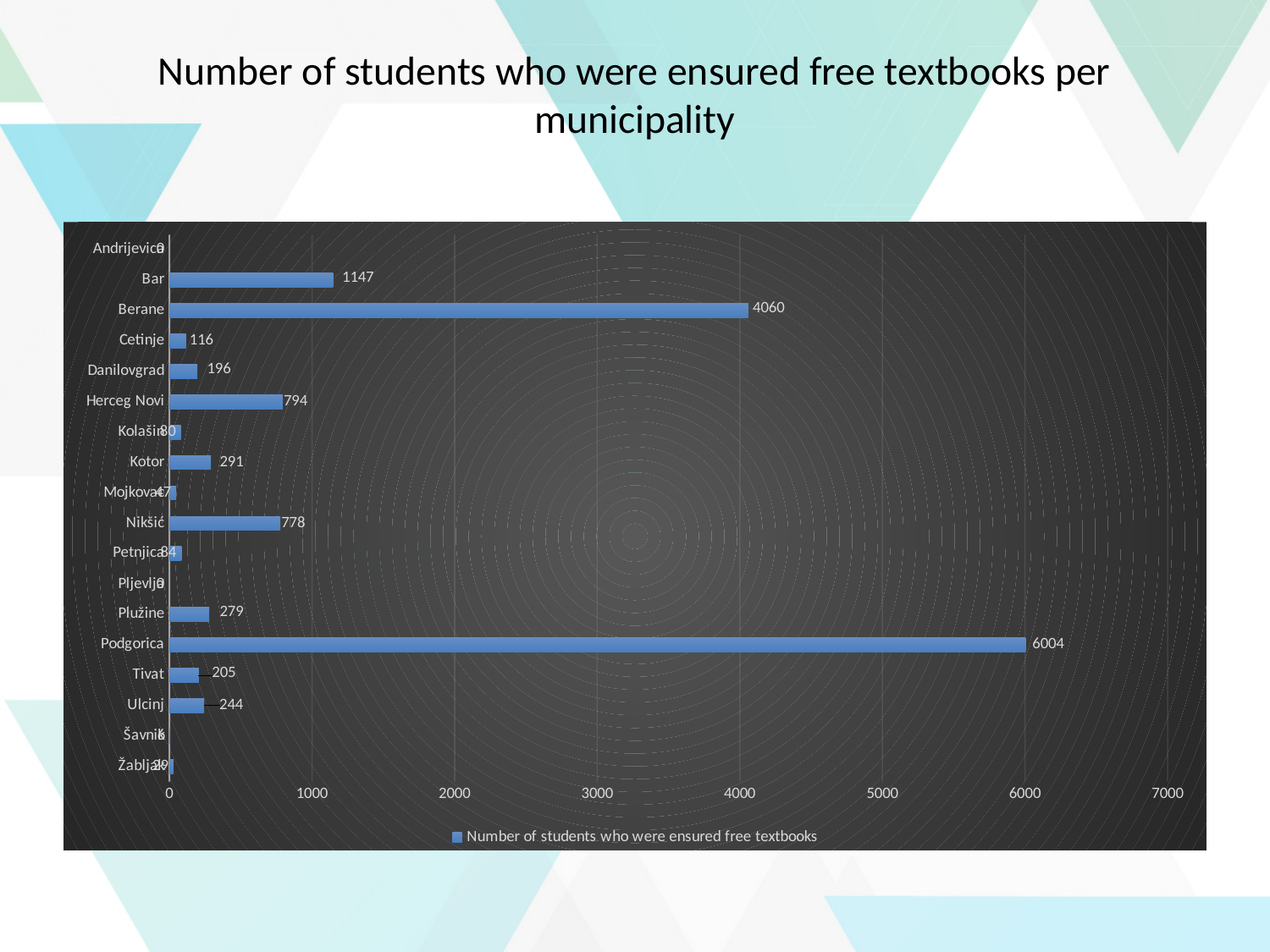
What is the value for Herceg Novi? 794 Which is larger, the value for Herceg Novi or the value for Nikšić? Herceg Novi How many municipalities are shown on the chart? 18 What is the difference between the values for Kotor and Plužine? 12 What is the difference between the values for Podgorica and Berane? 1944 What is the value for Bar? 1147 What kind of chart is shown on the slide? bar chart What is the value for Podgorica? 6004 What is the value for Berane? 4060 Which municipality has the highest number of students who were ensured free textbooks? Podgorica How many series does the legend list? 1 Is the value for Bar greater or less than 1000? greater